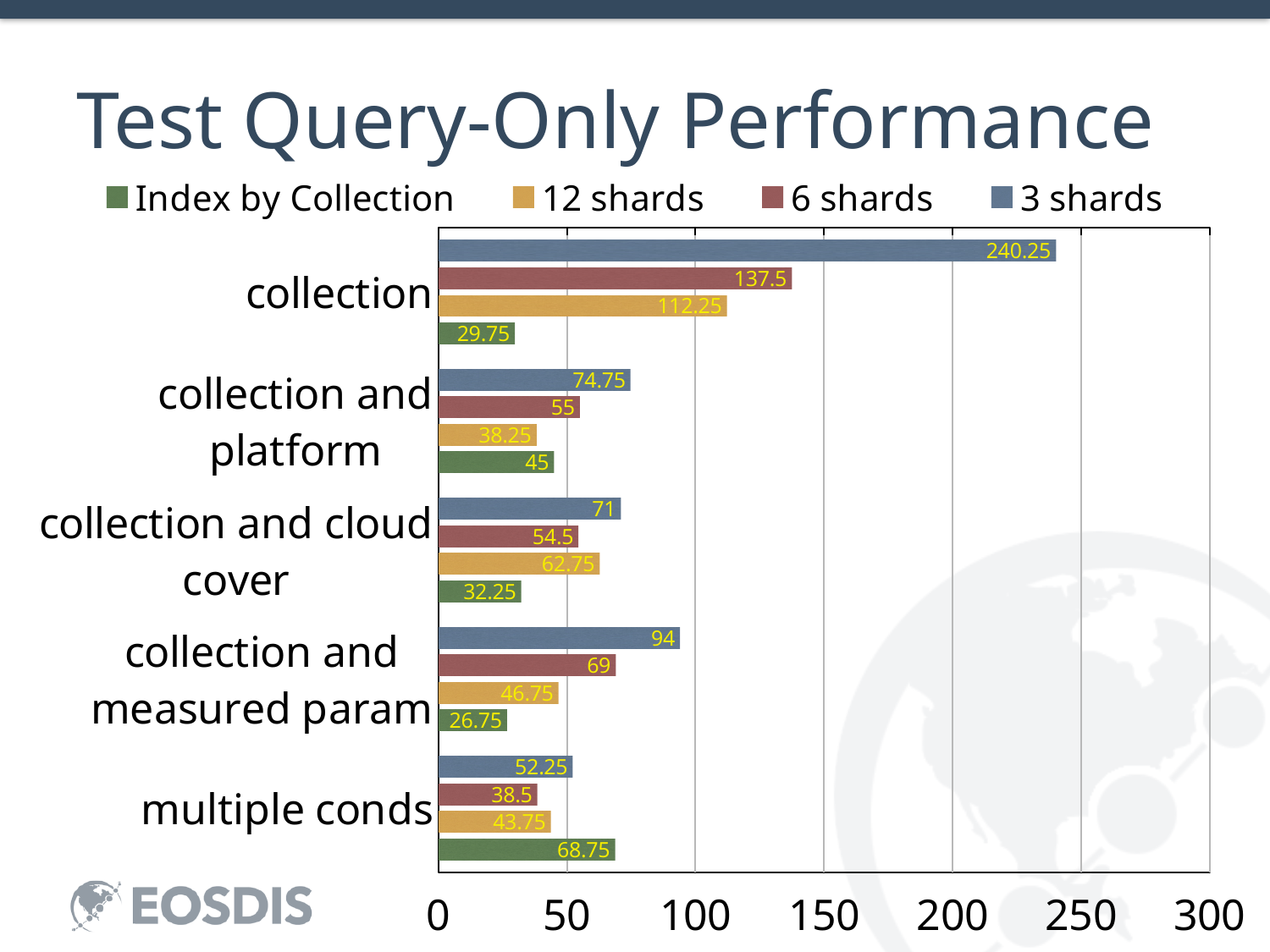
What is the value for 6 shards in the collection and measured param category? 69 What is the value for 12 shards in the collection and cloud cover category? 62.75 What is the value for 3 shards in the collection category? 240.25 What is the difference between the 3 shards and 6 shards values in the collection category? 102.75 Which category has the lowest value for Index by Collection? collection and measured param What is the value for Index by Collection in the multiple conds category? 68.75 Is the value for 3 shards in the collection and measured param category greater or less than 100? less Which category has the highest value for 3 shards? collection How many categories are shown on the chart? 5 How many series does the legend list? 4 In the multiple conds category, which is larger: the 12 shards value or the 6 shards value? 12 shards What kind of chart is shown on the slide? bar chart